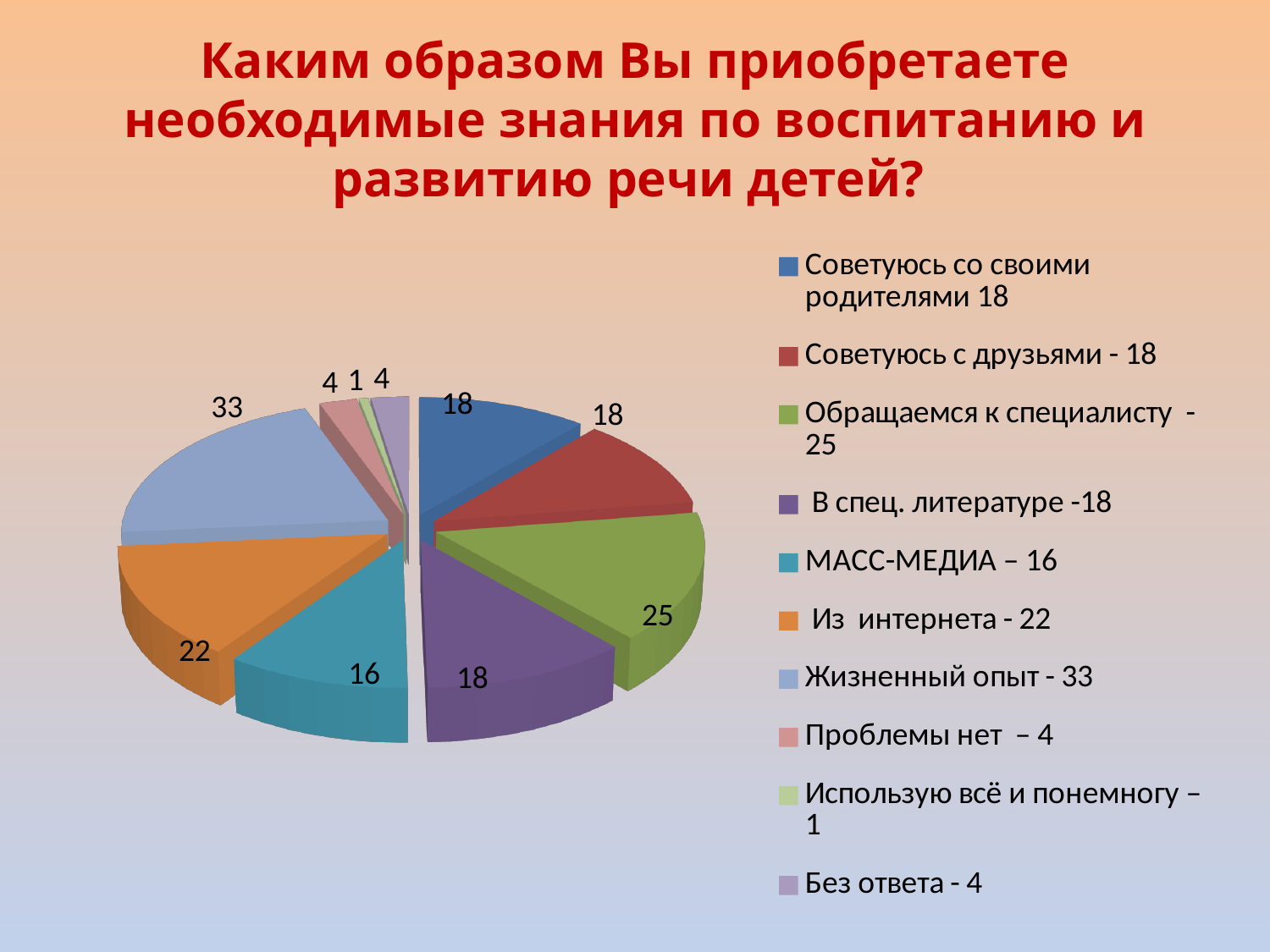
How many entries does the legend list? 10 How many slices does the pie chart have? 10 What kind of chart is shown on the slide? Pie chart What is the value for "Из интернета"? 22 What is the value for "Проблемы нет"? 4 Which category has the largest slice in the pie chart? Жизненный опыт Which category has the smallest slice in the pie chart? Использую всё и понемногу Which is larger: the value for "Из интернета" or the value for "В спец. литературе"? Из интернета What is the value for "Обращаемся к специалисту"? 25 What is the difference between the values for "Жизненный опыт" and "Из интернета"? 11 What is the difference between the values for "Обращаемся к специалисту" and "МАСС-МЕДИА"? 9 What is the value for "МАСС-МЕДИА"? 16